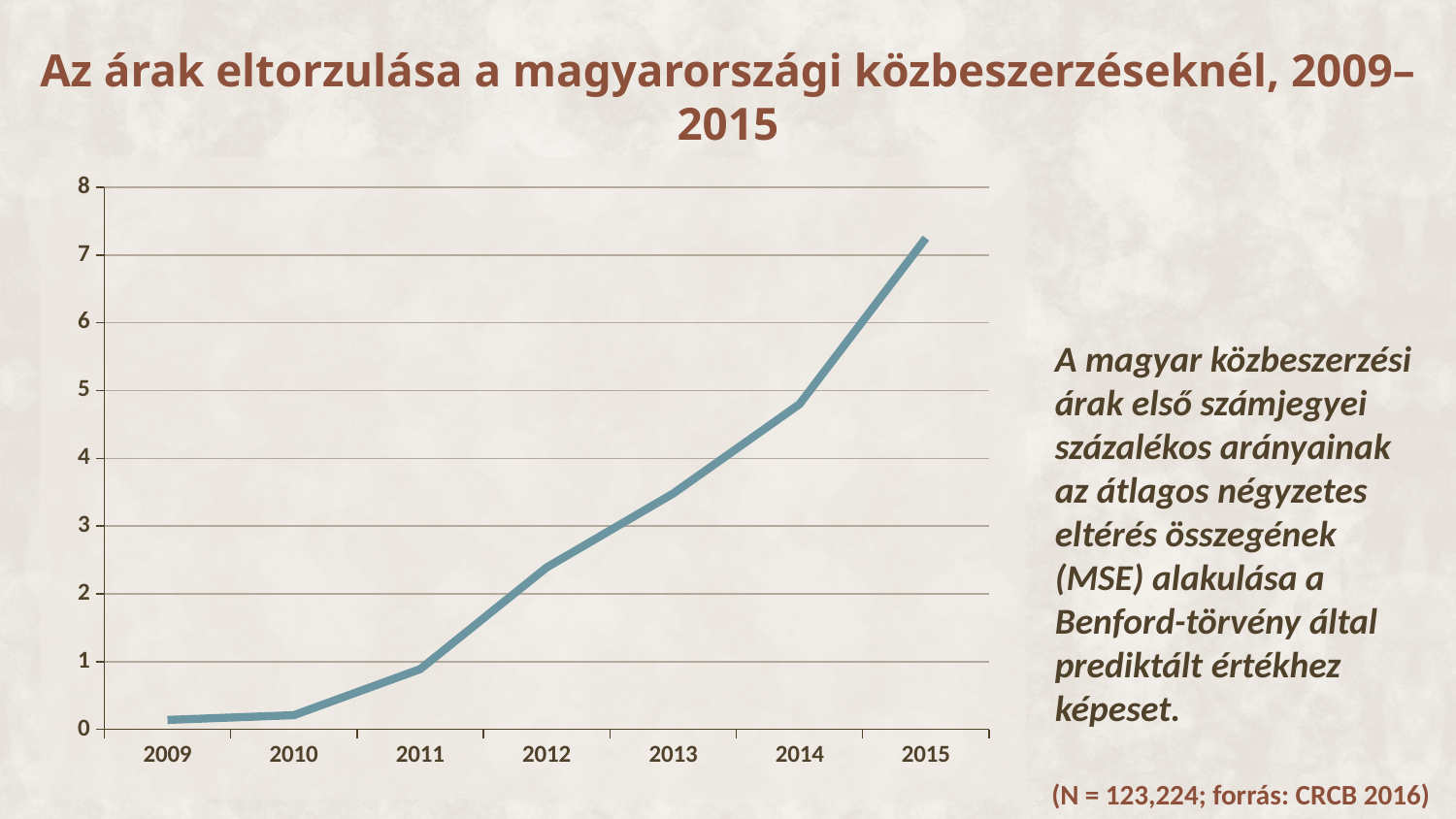
Is the value for 2014 greater or less than 5? less What is the title of the chart on the slide? Az árak eltorzulása a magyarországi közbeszerzéseknél, 2009–2015 What is the highest tick value shown on the y axis? 8 Is the value for 2012 greater or less than 2? greater Which year has the larger value, 2013 or 2014? 2014 Which year has the highest value? 2015 What kind of chart is shown on the slide? line chart Do the values rise or fall from 2009 to 2015? rise Which year has the lowest value? 2009 How many years are plotted along the x axis? 7 Is the value for 2011 greater or less than 1? less